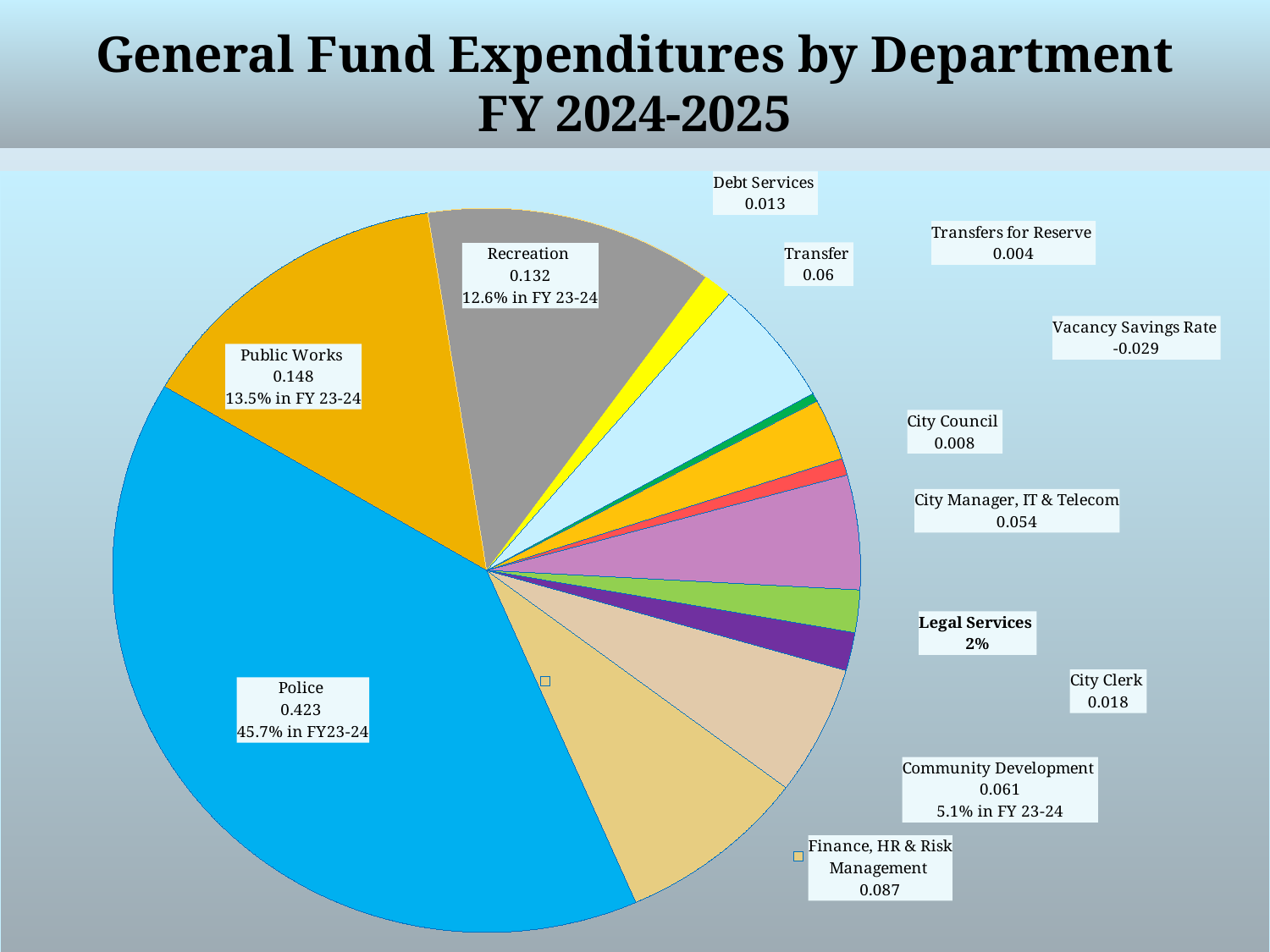
Which department has the largest share of the pie? Police What value is shown for Vacancy Savings Rate? -0.029 What kind of chart is shown on the slide? pie chart What value is shown for Community Development? 0.061 What value is shown for Public Works? 0.148 What is the title of the chart? General Fund Expenditures by Department FY 2024-2025 What value is shown for Finance, HR & Risk Management? 0.087 What value is shown for Police? 0.423 What value is shown for Recreation? 0.132 What was the Police share in FY23-24, according to the label? 45.7% Which is larger, the value for City Manager, IT & Telecom or the value for Transfer? Transfer What is the difference between the values for Public Works and Recreation? 0.016